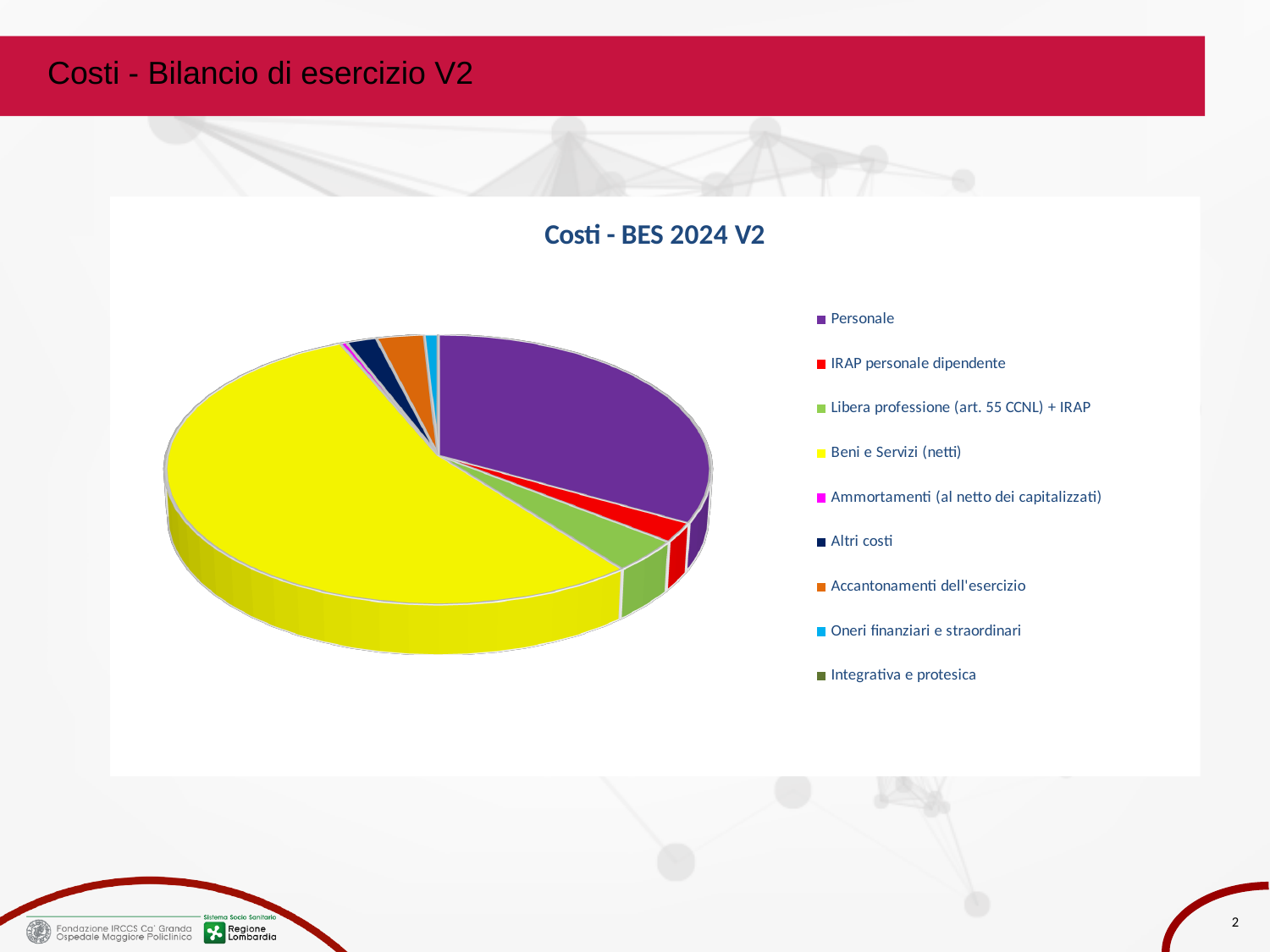
Which slice is larger, Personale or Libera professione (art. 55 CCNL) + IRAP? Personale What is the title of the chart? Costi - BES 2024 V2 Which slice is larger, Beni e Servizi (netti) or Altri costi? Beni e Servizi (netti) What colour is the Personale slice in the chart? Purple How many categories does the legend of the chart list? 9 Which category has the largest slice of the pie? Beni e Servizi (netti) Which slice is larger, Beni e Servizi (netti) or Personale? Beni e Servizi (netti) What kind of chart is shown on the slide? Pie chart